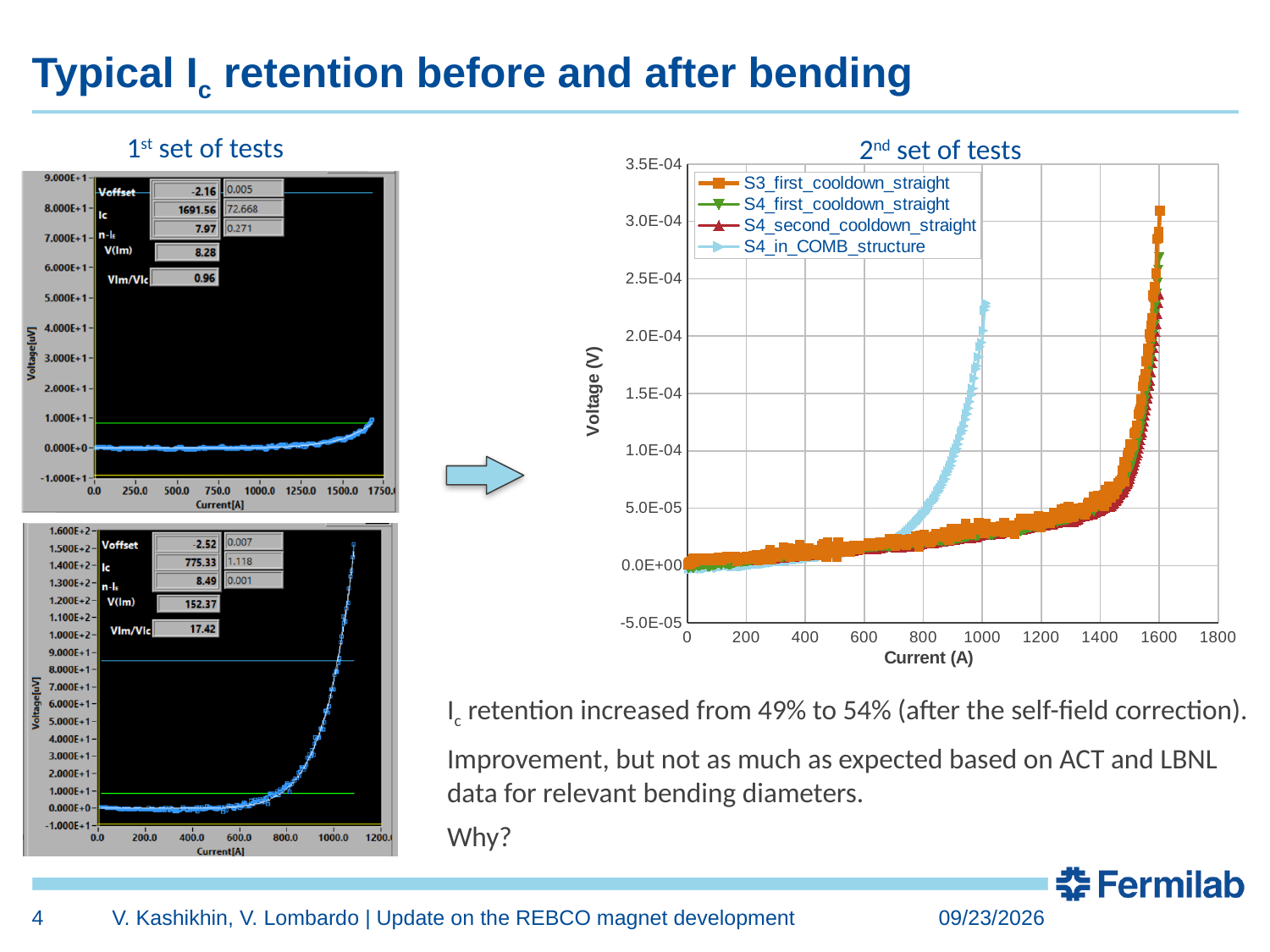
On the '2nd set of tests' chart, is the current at which S3_first_cooldown_straight reaches its highest voltage greater or less than 1400 A? greater On the '2nd set of tests' chart, is the highest voltage reached by S4_in_COMB_structure greater or less than 2.0E-04? greater On the '2nd set of tests' chart, which series shows its sharp voltage rise at the lowest current? S4_in_COMB_structure On the '2nd set of tests' chart, what is the label of the x axis? Current (A) On the '2nd set of tests' chart, does the voltage rise or fall as the current increases? rise What is the difference between the Ic values shown on the top and bottom charts of the '1st set of tests'? 916.23 On the bottom chart of the '1st set of tests', what is the value shown for Ic? 775.33 On the '2nd set of tests' chart, what is the label of the y axis? Voltage (V) On the bottom chart of the '1st set of tests', what is the value shown for VIm/VIc? 17.42 On the '2nd set of tests' chart, how many series does the legend list? 4 On the top chart of the '1st set of tests', what is the value shown for Ic? 1691.56 On the top chart of the '1st set of tests', what is the value shown for Voffset? -2.16